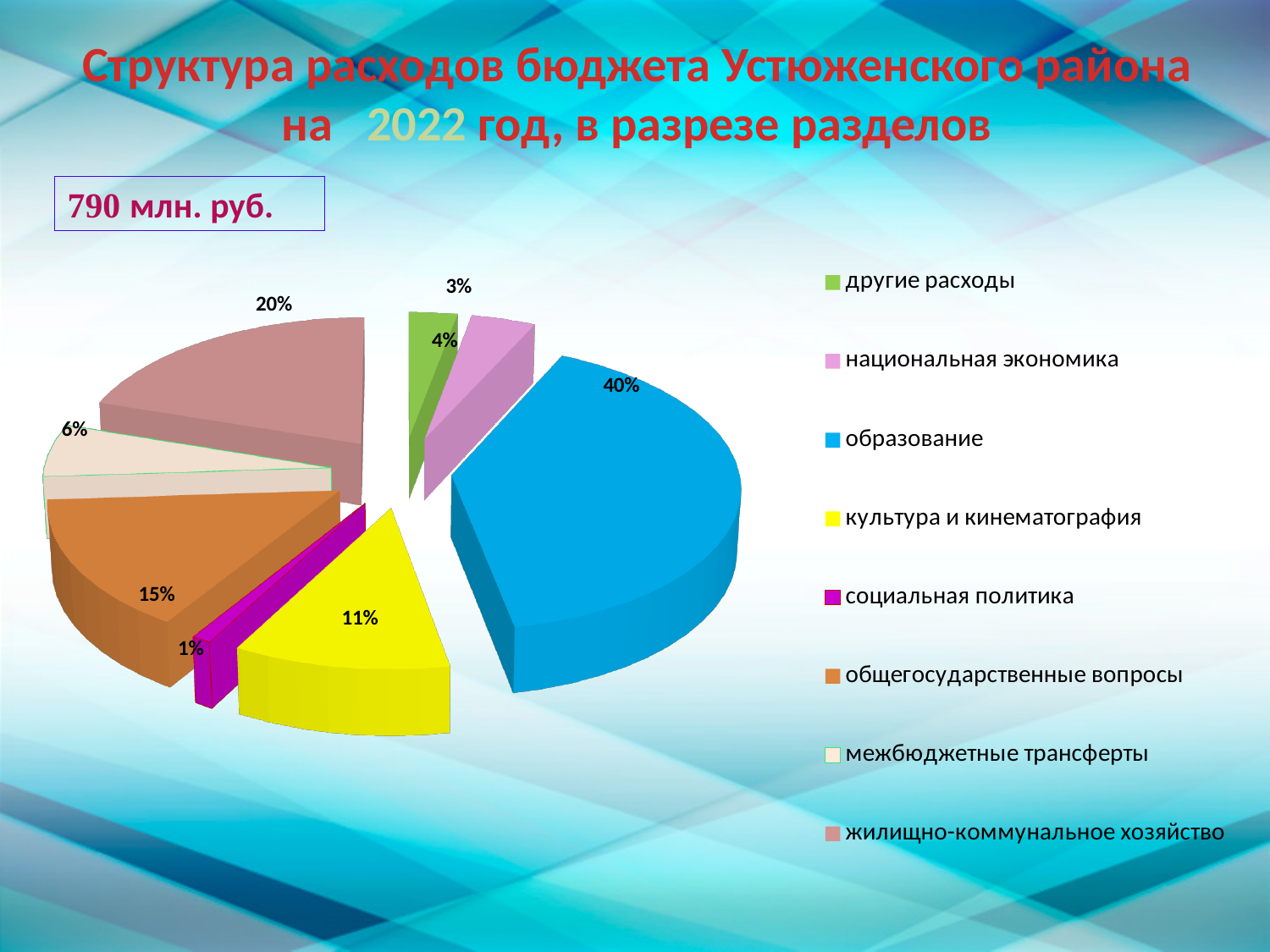
What share of the pie does культура и кинематография have? 11% Which category has the largest share of the pie? образование Which category has the smallest share of the pie? социальная политика What share of the pie does общегосударственные вопросы have? 15% What share of the pie does жилищно-коммунальное хозяйство have? 20% What kind of chart is shown on the slide? pie chart How many categories does the legend list? 8 What is the difference in percentage points between образование and жилищно-коммунальное хозяйство? 20 What share of the pie does социальная политика have? 1% What total budget amount is shown in the box above the chart? 790 млн. руб. What share of the pie does образование have? 40% Which is larger, the share for межбюджетные трансферты or the share for национальная экономика? межбюджетные трансферты